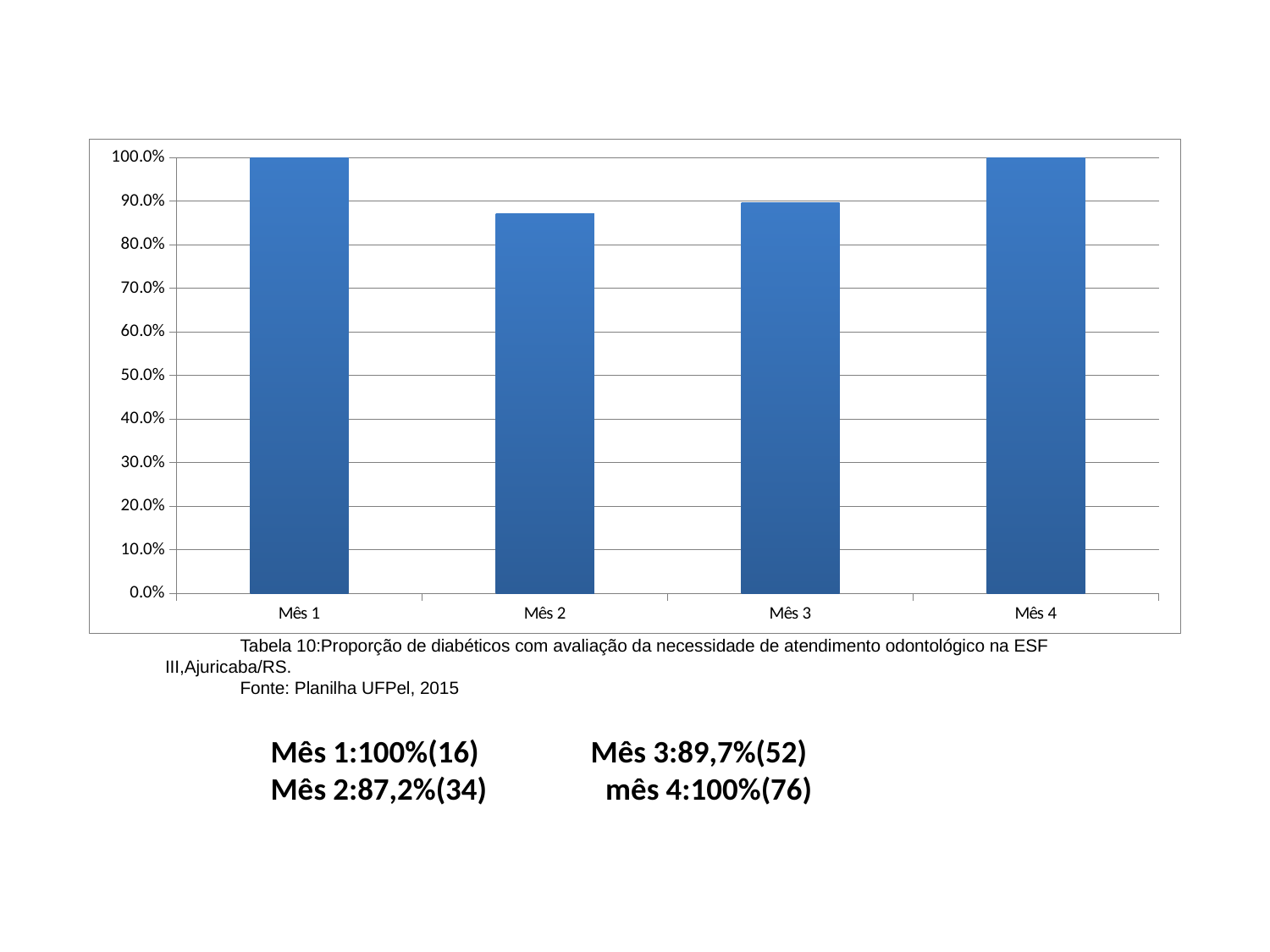
Is the value for Mês 1 greater or less than 90%? greater Which month has the lowest value? Mês 2 How many months are shown on the x axis? 4 What is the value for Mês 4? 100% Which is larger, the value for Mês 2 or the value for Mês 3? Mês 3 Does the value rise or fall from Mês 1 to Mês 2? fall What is the value for Mês 3? 89,7% What is the value for Mês 2? 87,2% Is the value for Mês 2 greater or less than 90%? less What source is cited below the chart? Planilha UFPel, 2015 What is the difference between the value for Mês 4 and the value for Mês 2? 12,8 percentage points What kind of chart is shown on the slide? bar chart